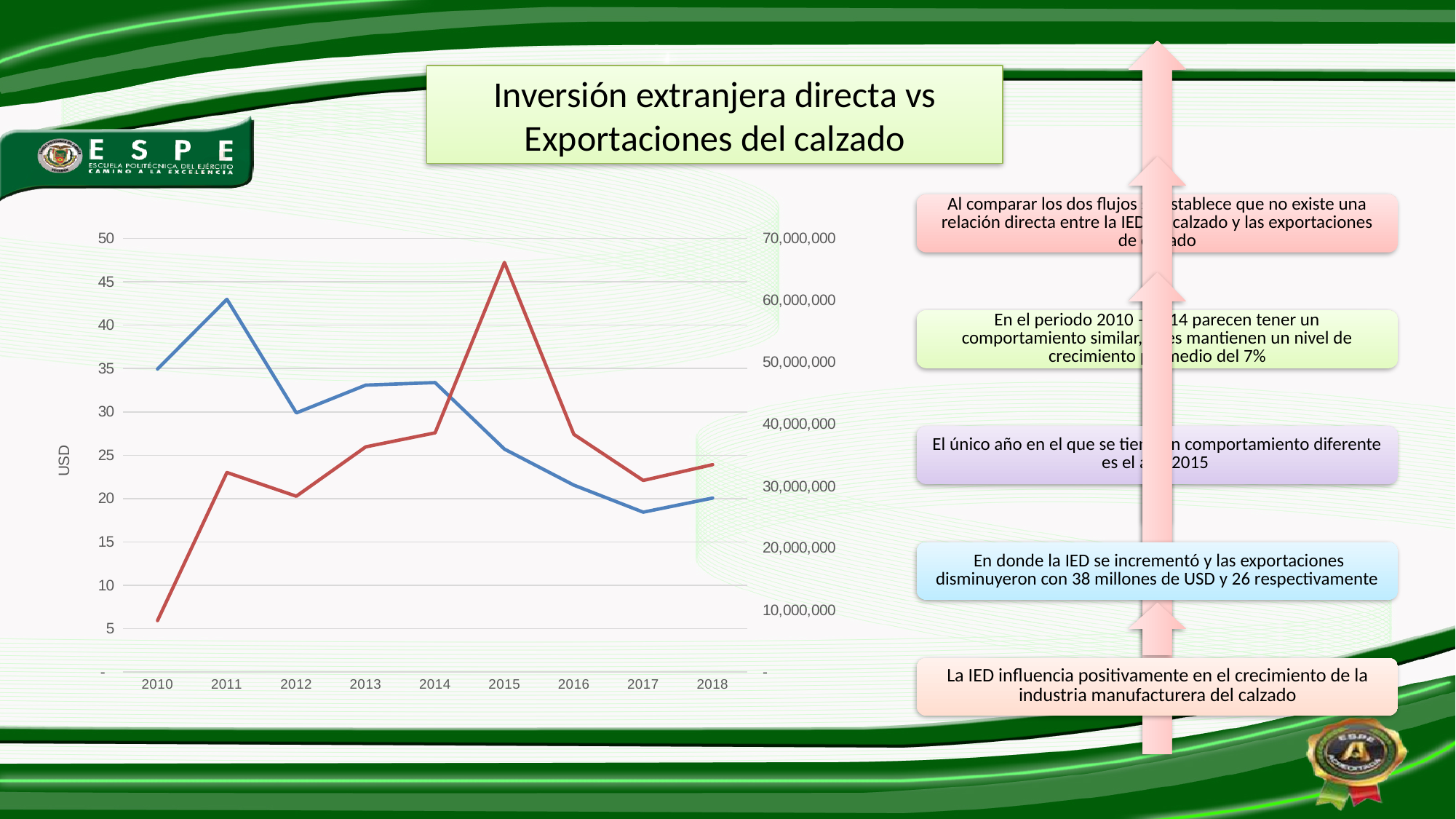
In which year does the blue line reach its lowest point? 2017 What is the label on the left vertical axis of the chart? USD What is the title of the chart on the slide? Inversión extranjera directa vs Exportaciones del calzado Which line is higher in 2015, the blue line or the red line? Red line In which year does the red line reach its highest point? 2015 Does the blue line rise or fall from 2014 to 2017? Fall What kind of chart is shown on the slide? Line chart Which line is higher in 2010, the blue line or the red line? Blue line In which year does the red line reach its lowest point? 2010 In which year does the blue line reach its highest point? 2011 How many years are plotted along the x axis of the chart? 9 Does the red line rise or fall from 2015 to 2017? Fall